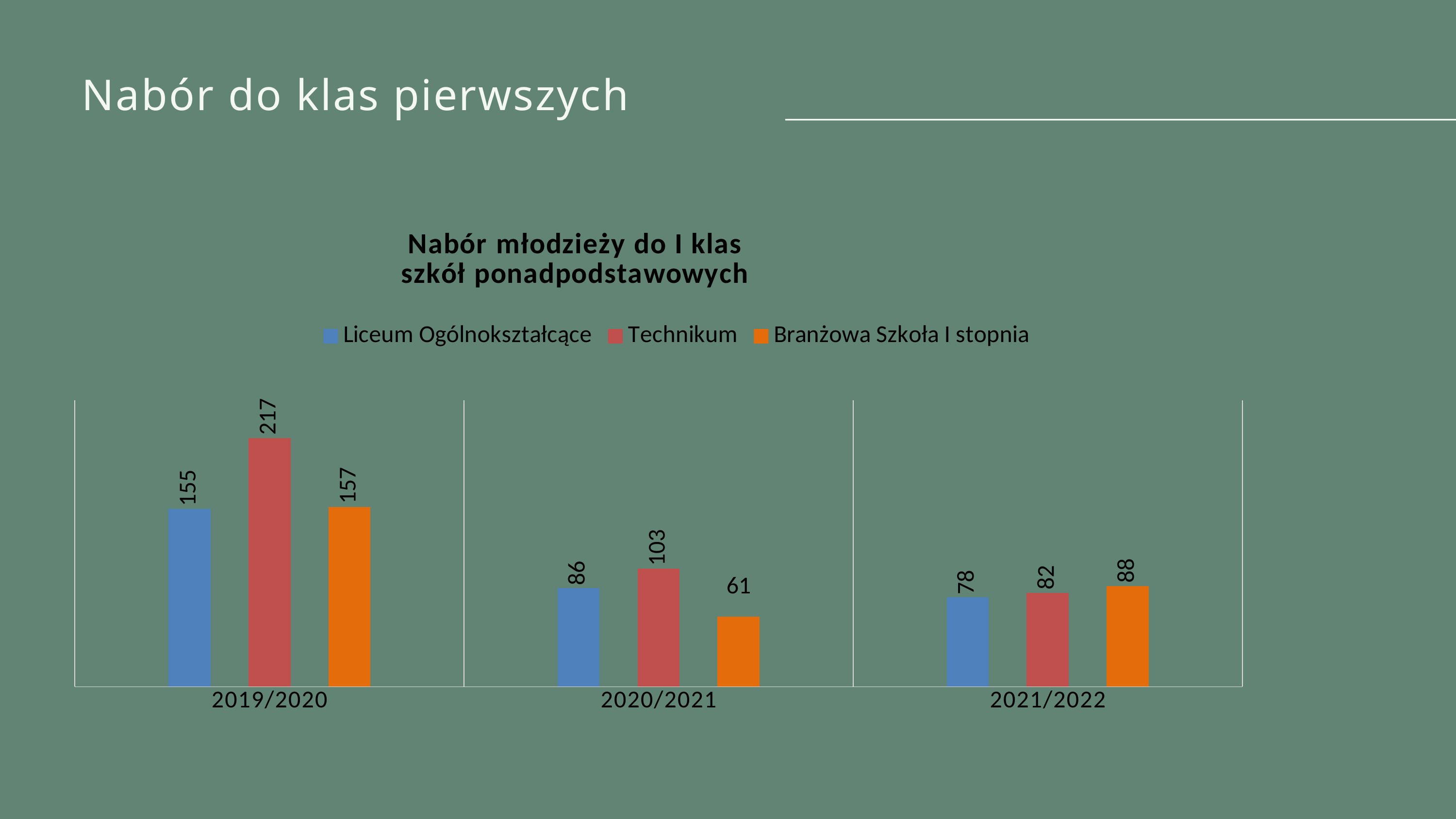
What is the title of the chart? Nabór młodzieży do I klas szkół ponadpodstawowych What kind of chart is shown on the slide? bar chart Do the Technikum values rise or fall from 2019/2020 to 2021/2022? fall What is the value for Technikum in 2019/2020? 217 What is the value for Branżowa Szkoła I stopnia in 2021/2022? 88 What is the value for Liceum Ogólnokształcące in 2020/2021? 86 Which series has the lowest value in 2020/2021? Branżowa Szkoła I stopnia Which is larger in 2021/2022: Liceum Ogólnokształcące or Branżowa Szkoła I stopnia? Branżowa Szkoła I stopnia Which series has the highest value in 2019/2020? Technikum What is the difference between the Technikum values for 2019/2020 and 2020/2021? 114 How many series does the legend list? 3 How many school years are shown on the x axis? 3